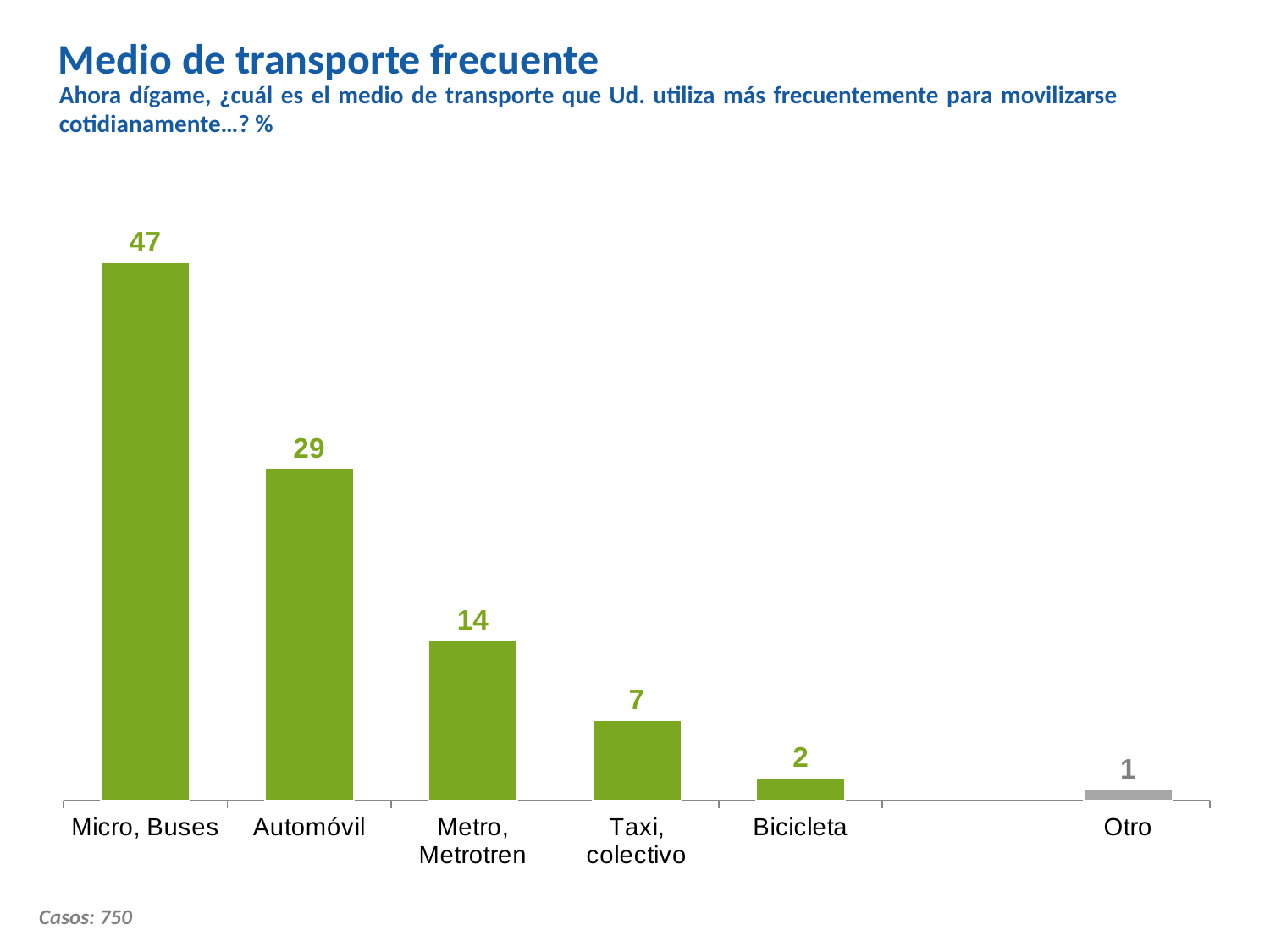
What is the value for Bicicleta? 2 Which category has the lowest value? Otro What is the title of the chart? Medio de transporte frecuente What kind of chart is shown on the slide? Bar chart What is the value for Taxi, colectivo? 7 What is the value for Metro, Metrotren? 14 What is the value for Micro, Buses? 47 Do the values rise or fall from left to right across the categories? Fall Which is larger, the value for Metro, Metrotren or the value for Taxi, colectivo? Metro, Metrotren What is the difference between the values for Micro, Buses and Automóvil? 18 Which category has the highest value? Micro, Buses What is the value for Automóvil? 29